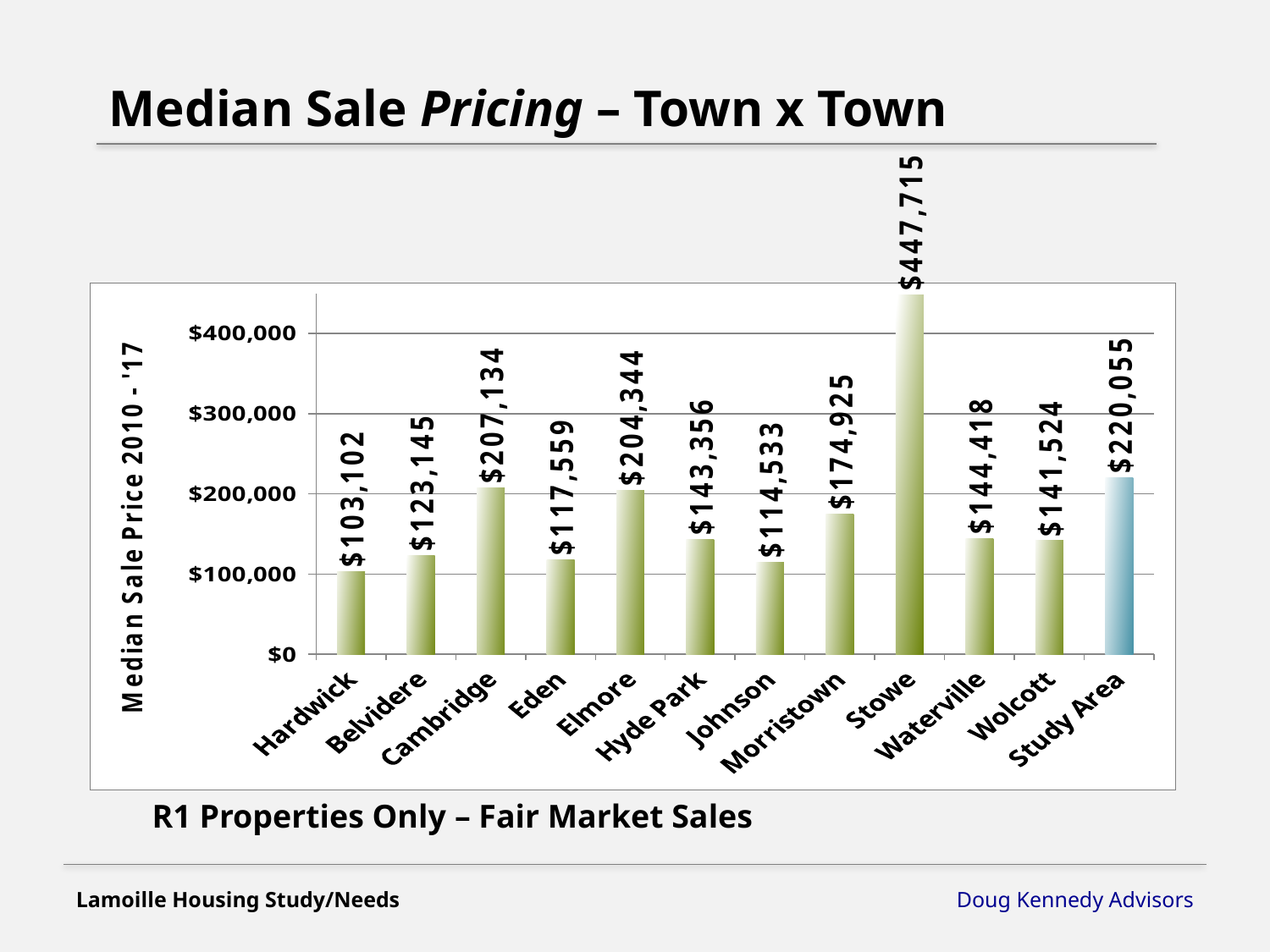
What is the difference between the median sale price for Cambridge and Elmore? $2,790 What is the median sale price for Cambridge? $207,134 How many categories are shown on the x axis? 12 What is the median sale price for Stowe? $447,715 Which town has the highest median sale price? Stowe What is the median sale price for the Study Area? $220,055 Which town has the lowest median sale price? Hardwick Is the median sale price for Johnson greater or less than $200,000? less What is the difference between the median sale price for Stowe and the Study Area? $227,660 What kind of chart is shown on the slide? bar chart Which has a higher median sale price, Morristown or Hyde Park? Morristown What is the y-axis label of the chart? Median Sale Price 2010 - '17